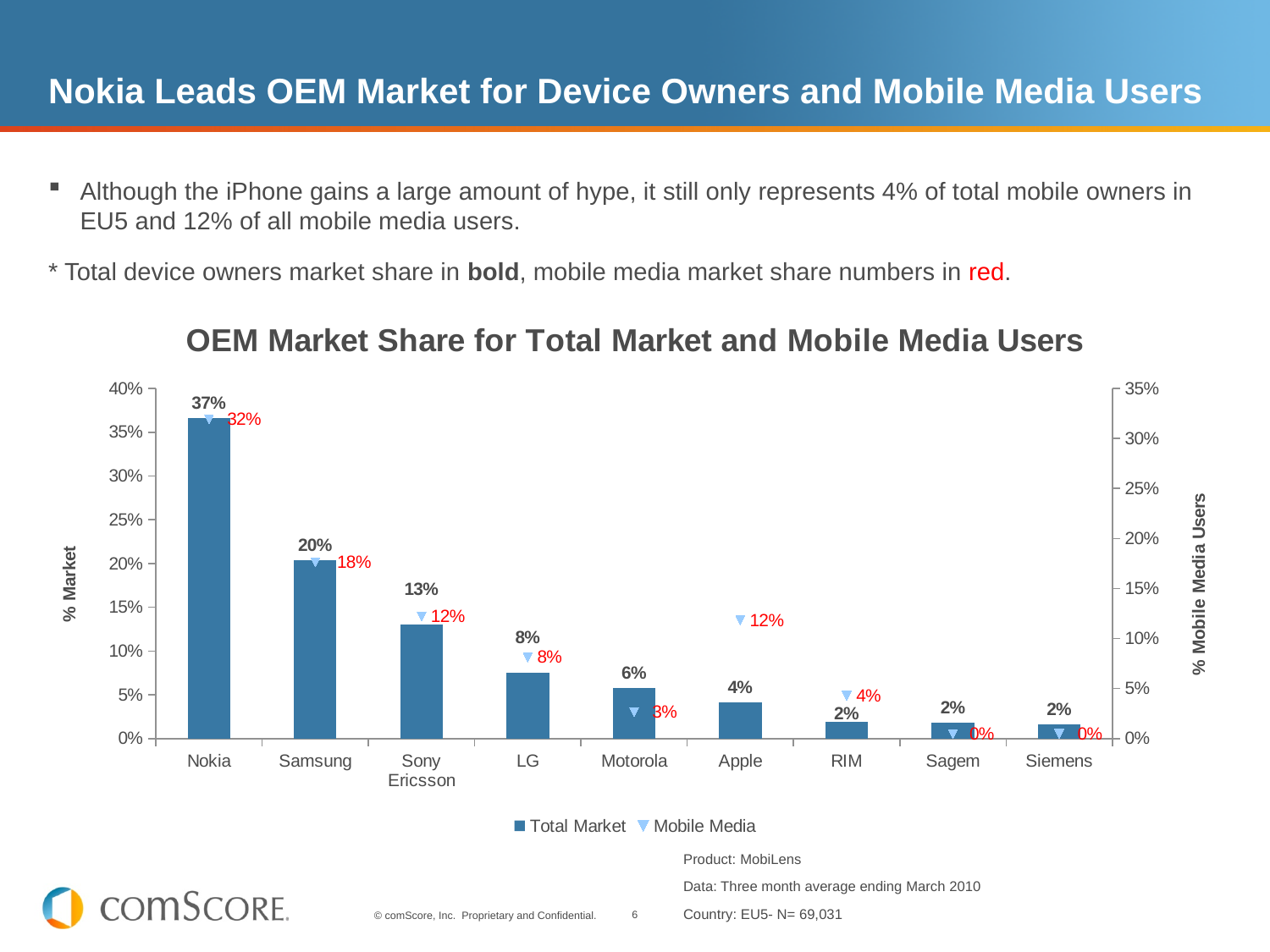
What kind of chart is shown on the slide? Bar chart What is the Total Market share for Sony Ericsson? 13% What is the difference between Nokia's Total Market share and its Mobile Media share? 5% What is the title of the chart? OEM Market Share for Total Market and Mobile Media Users What is the difference between Samsung's and Sony Ericsson's Total Market share? 7% How many OEMs are shown on the x axis? 9 What is the Mobile Media share for Apple? 12% How many series does the legend list? 2 Which is larger, Apple's Mobile Media share or Motorola's Mobile Media share? Apple's Mobile Media share What is the Mobile Media share for Samsung? 18% Which OEM has the highest Total Market share? Nokia What is the Total Market share for Nokia? 37%